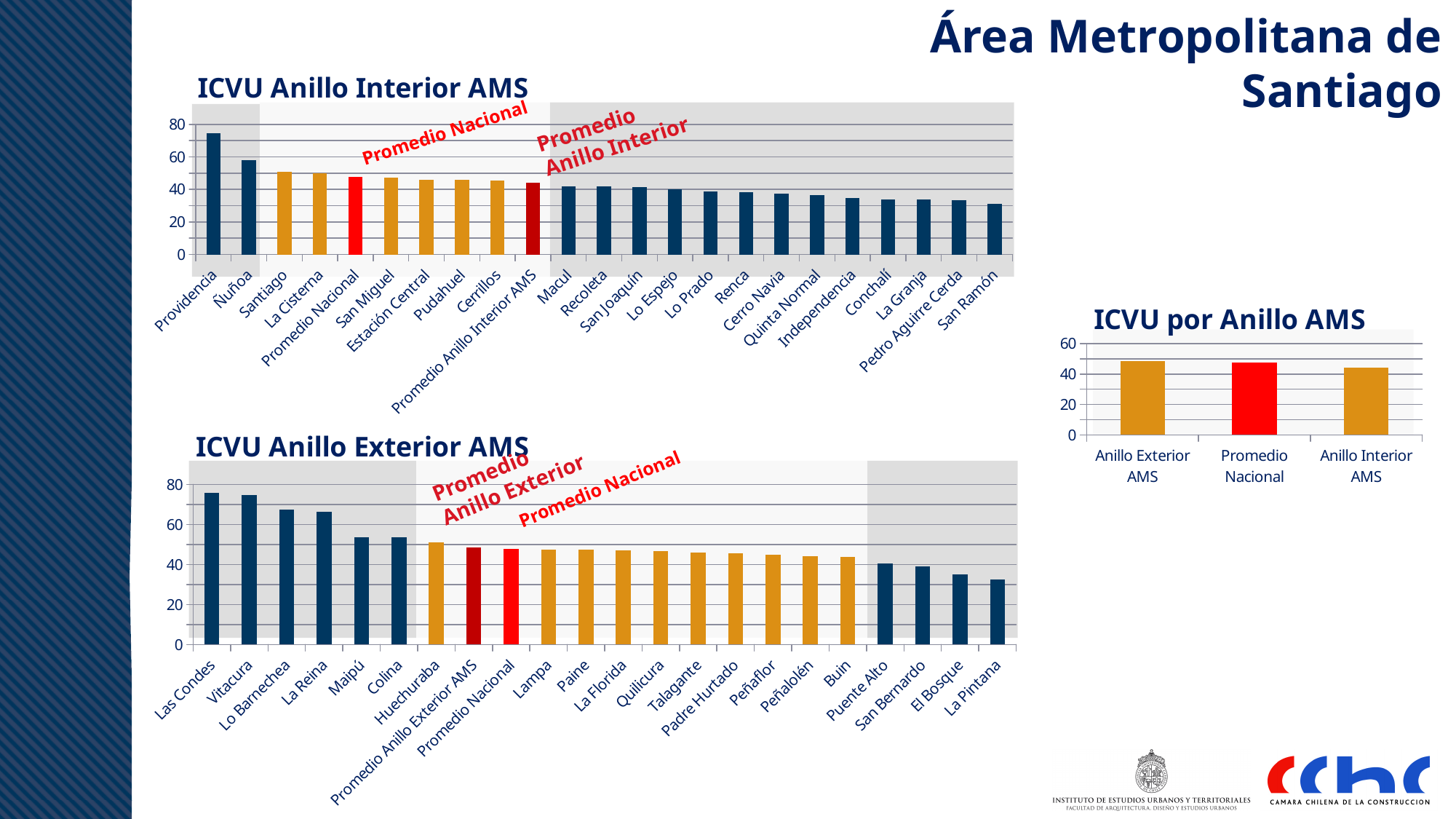
How many categories are shown on the x axis of the 'ICVU Anillo Exterior AMS' chart? 22 In the 'ICVU Anillo Interior AMS' chart, is the value for San Ramón greater or less than 40? less What kind of chart is the 'ICVU Anillo Interior AMS' chart? bar chart In the 'ICVU Anillo Interior AMS' chart, which is larger, the value for Providencia or the value for Ñuñoa? Providencia In the 'ICVU Anillo Interior AMS' chart, is the value for Providencia greater or less than 60? greater In the 'ICVU Anillo Exterior AMS' chart, which is larger, the value for Las Condes or the value for Maipú? Las Condes In the 'ICVU Anillo Exterior AMS' chart, is the value for Las Condes greater or less than 60? greater In the 'ICVU Anillo Interior AMS' chart, which category has the highest value? Providencia How many categories are shown in the 'ICVU por Anillo AMS' chart? 3 In the 'ICVU por Anillo AMS' chart, which category has the lowest value? Anillo Interior AMS In the 'ICVU Anillo Interior AMS' chart, which category has the lowest value? San Ramón In the 'ICVU Anillo Interior AMS' chart, do the values generally rise or fall from left to right along the x axis? fall